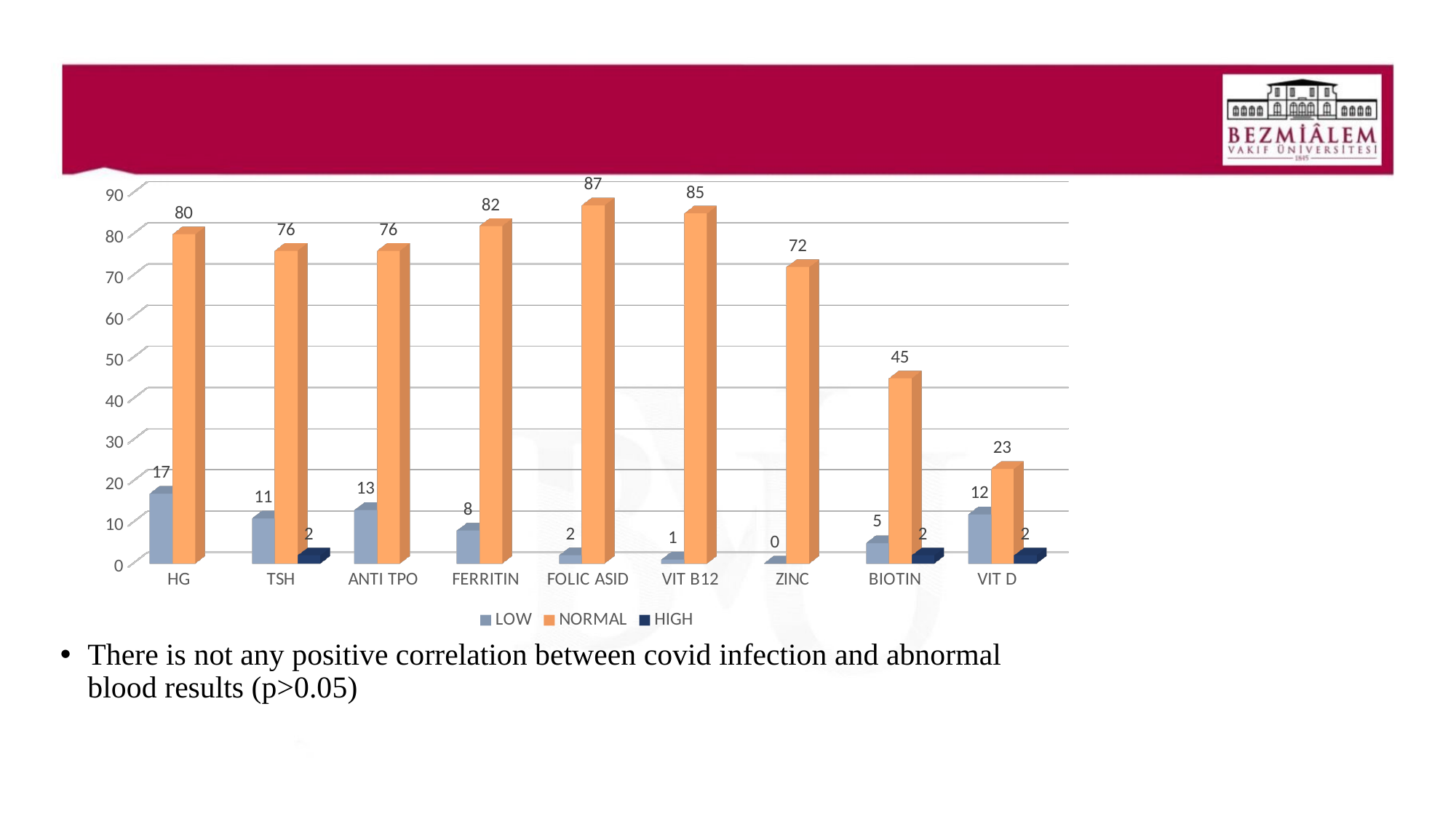
What is the LOW value for HG? 17 Which category has the lowest LOW value? ZINC What is the difference between the NORMAL values for VIT B12 and ZINC? 13 What kind of chart is shown on the slide? Bar chart What is the HIGH value for BIOTIN? 2 Which category has the highest NORMAL value? FOLIC ASID What is the NORMAL value for FOLIC ASID? 87 How many categories are shown on the x axis? 9 How many series does the legend list? 3 What are the three series listed in the legend? LOW, NORMAL, HIGH What is the NORMAL value for VIT D? 23 Which is larger, the LOW value for ANTI TPO or the LOW value for TSH? ANTI TPO